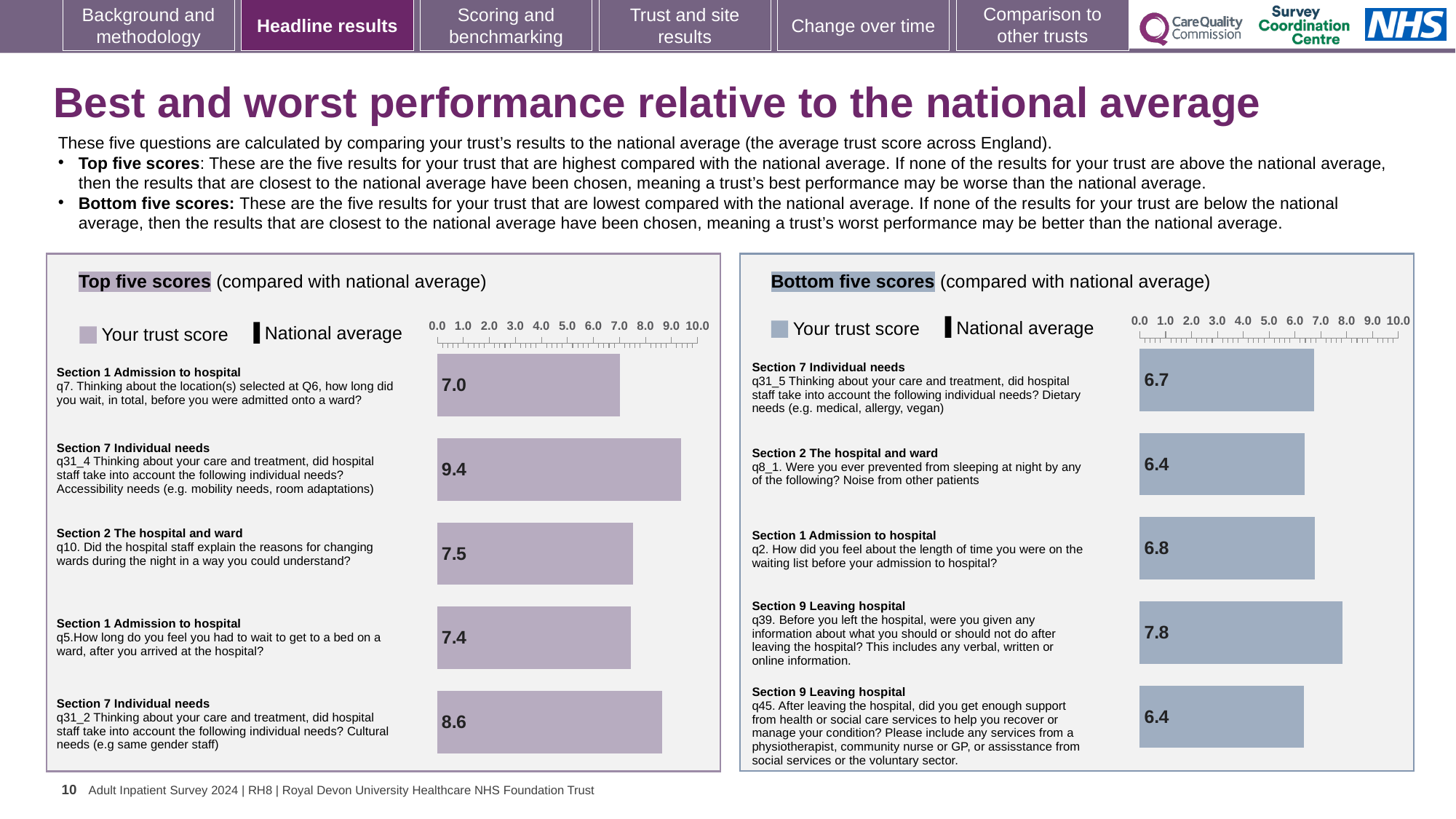
In the Top five scores chart, which has the higher trust score: q10 or q5? q10 In the Top five scores chart, which question has the highest trust score? q31_4 (accessibility needs), 9.4 How many bars are plotted in the Bottom five scores chart? 5 In the Top five scores chart, what is the difference between the trust scores for q31_4 and q7? 2.4 In the Top five scores chart, which question has the lowest trust score? q7 (how long did you wait before being admitted onto a ward), 7.0 In the Bottom five scores chart, what is the trust score for q39 (information about what you should or should not do after leaving the hospital)? 7.8 In the Bottom five scores chart, what is the trust score for q2 (length of time on the waiting list before admission)? 6.8 How many entries does the legend of the Top five scores chart list? 2 In the Bottom five scores chart, which question has the highest trust score? q39 (information before leaving hospital), 7.8 In the Top five scores chart, what is the trust score for q31_4 (accessibility needs)? 9.4 What kind of chart is the Top five scores chart? Bar chart In the Bottom five scores chart, what is the difference between the trust scores for q39 and q8_1? 1.4